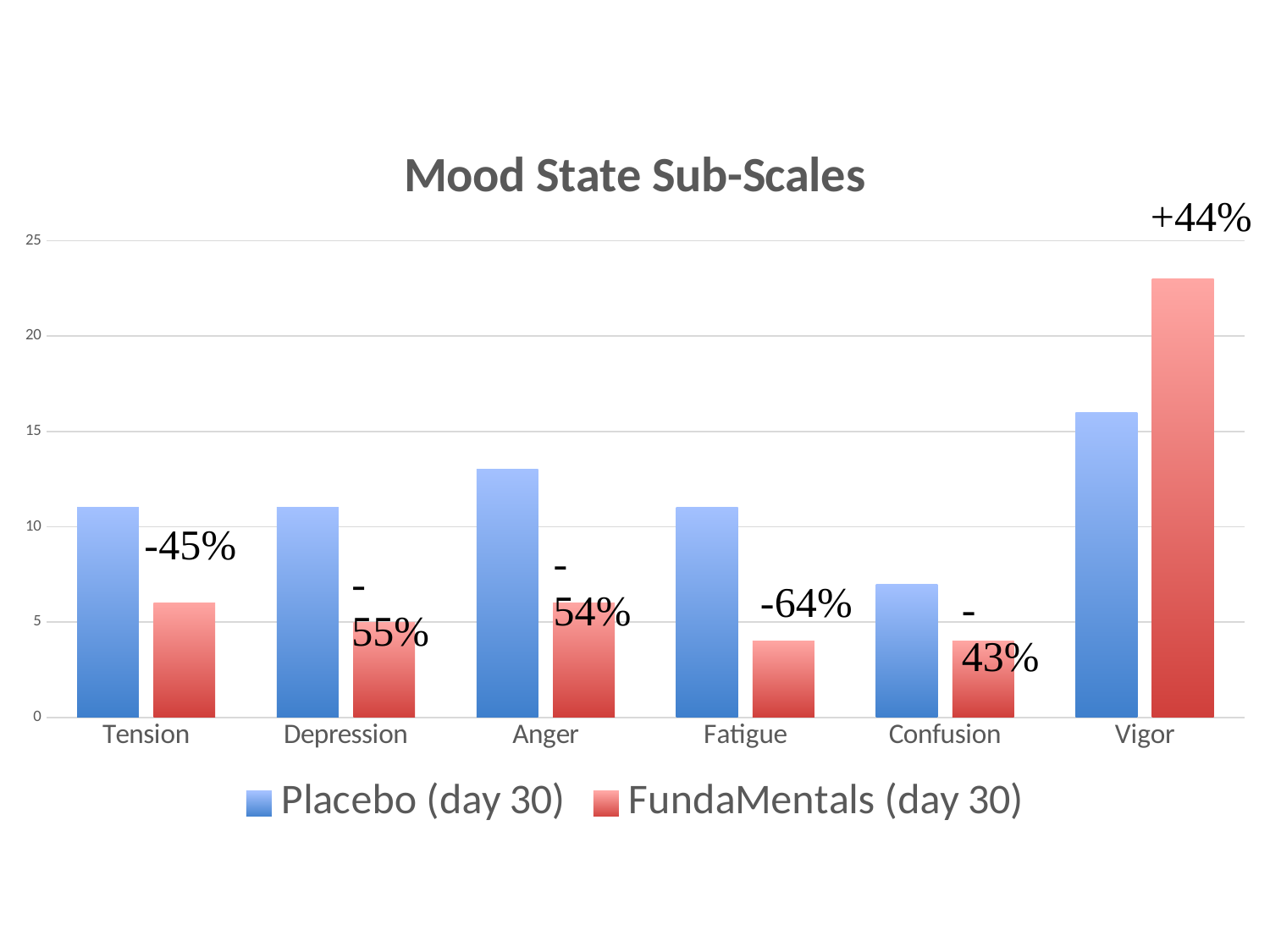
What percentage change is printed above the FundaMentals bar for Vigor? +44% How many series does the legend list? 2 For Vigor, which is larger: the Placebo (day 30) bar or the FundaMentals (day 30) bar? FundaMentals (day 30) What is the title of the chart? Mood State Sub-Scales What percentage change is printed above the FundaMentals bar for Fatigue? -64% What percentage change is printed next to the FundaMentals bar for Tension? -45% Which series is shown in red? FundaMentals (day 30) Which category has the highest Placebo (day 30) bar? Vigor What kind of chart is shown on the slide? bar chart Is the FundaMentals (day 30) value for Vigor greater or less than 20? greater How many mood sub-scale categories are shown on the x axis? 6 Which category has the lowest Placebo (day 30) bar? Confusion